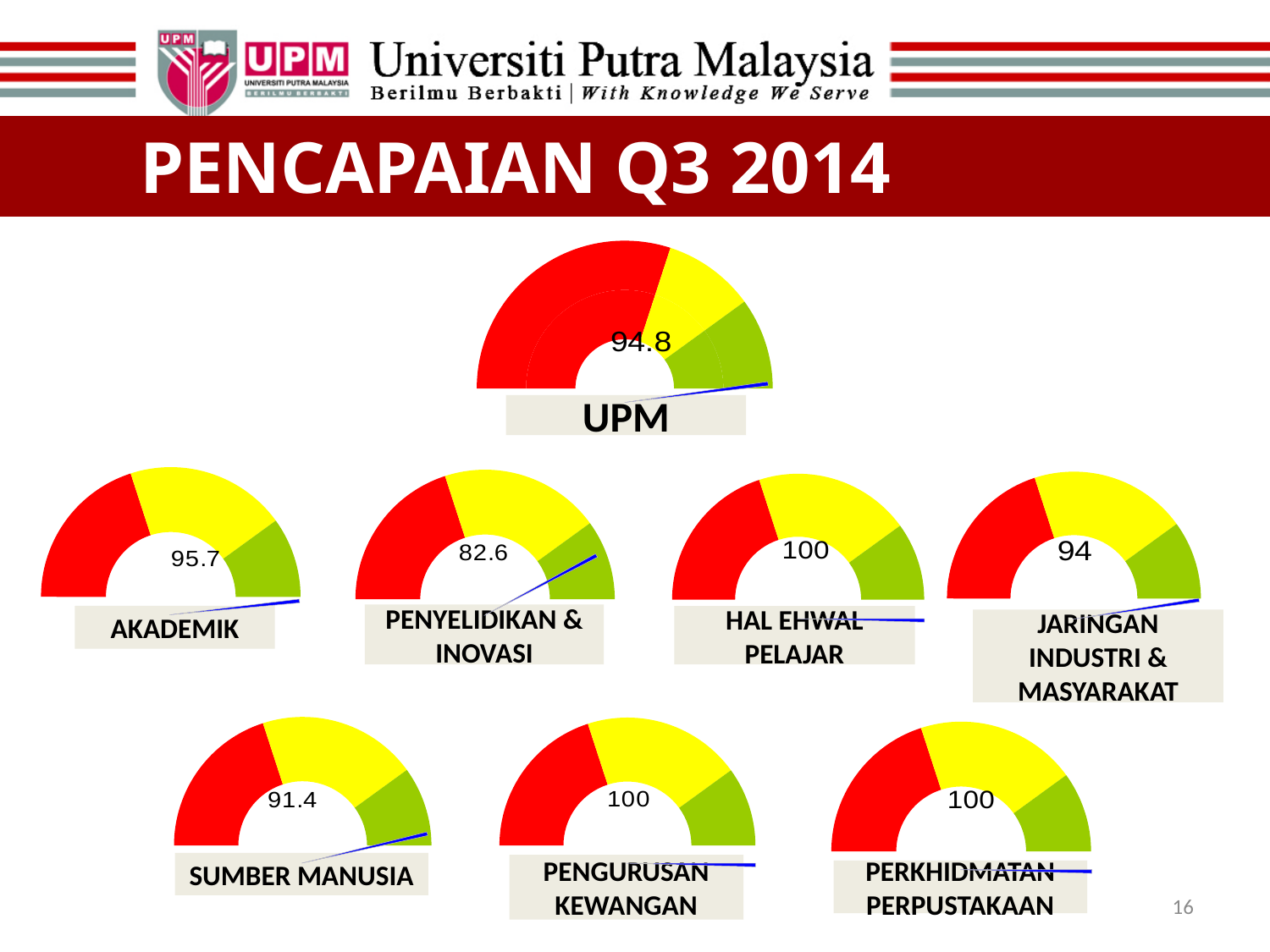
What value is shown on the UPM gauge? 94.8 How many gauge charts are shown on the slide in total? 8 What kind of chart is used to display the values on this slide? Gauge chart Which gauge on the slide shows the lowest value? PENYELIDIKAN & INOVASI How many gauges on the slide show a value of 100? 3 What value is shown on the SUMBER MANUSIA gauge? 91.4 What three colours make up the bands of each gauge? Red, yellow and green What value is shown on the JARINGAN INDUSTRI & MASYARAKAT gauge? 94 What value is shown on the PENYELIDIKAN & INOVASI gauge? 82.6 Which is larger, the AKADEMIK value or the JARINGAN INDUSTRI & MASYARAKAT value? AKADEMIK What is the difference between the AKADEMIK value and the PENYELIDIKAN & INOVASI value? 13.1 What value is shown on the AKADEMIK gauge? 95.7